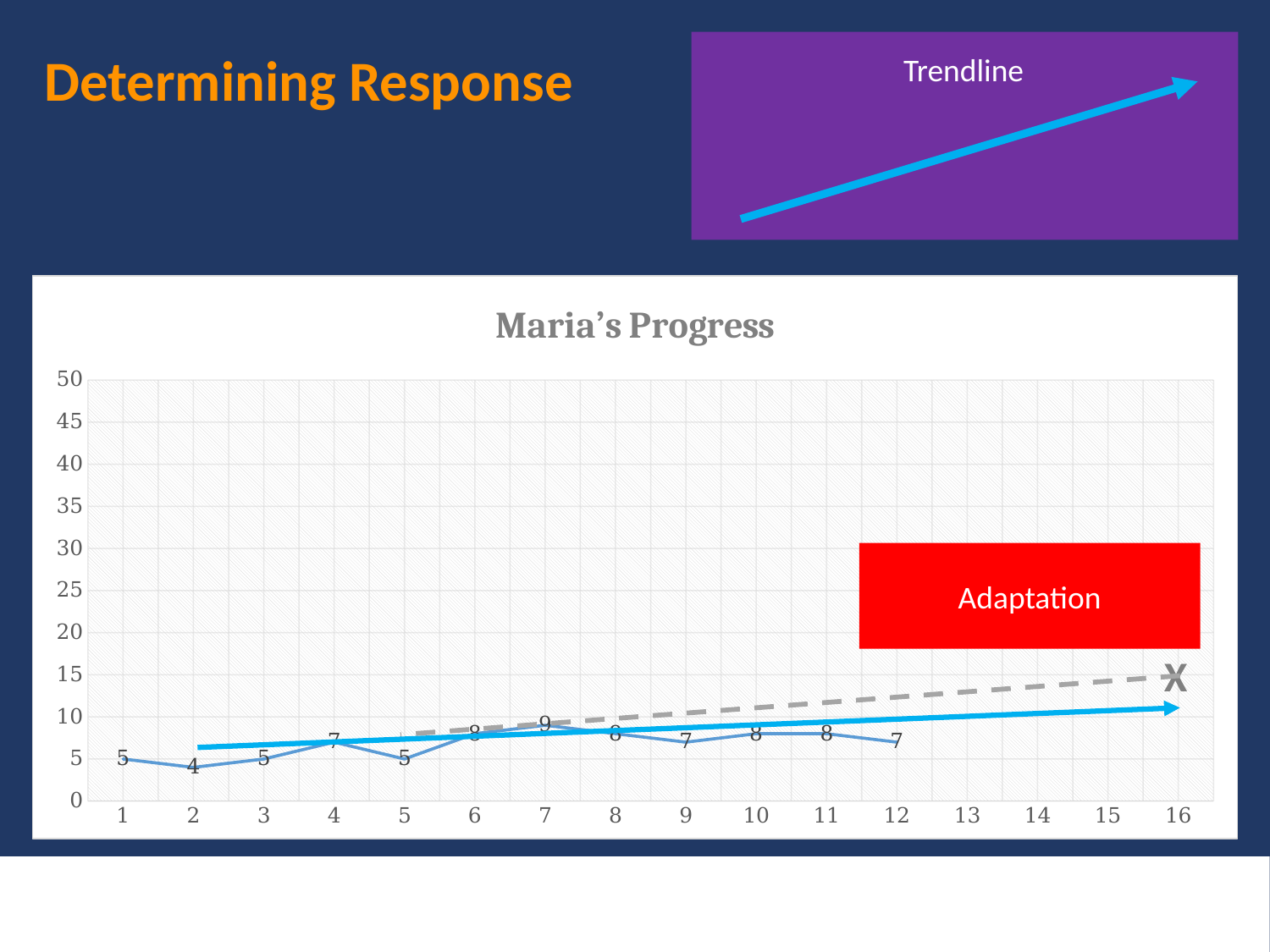
Is the value at x = 6 greater or less than 10? less How many data points are plotted with labels on the line? 12 What is the difference between the value at x = 7 and the value at x = 2? 5 What is the value plotted at x = 12? 7 What kind of chart is shown on the slide? line chart What is the value plotted at x = 7? 9 What is the title of the chart? Maria's Progress What is the value plotted at x = 2? 4 What is the highest value shown on the y axis? 50 Which is larger, the value at x = 4 or the value at x = 5? x = 4 At which x value does the plotted line reach its highest value? 7 At which x value does the plotted line reach its lowest value? 2